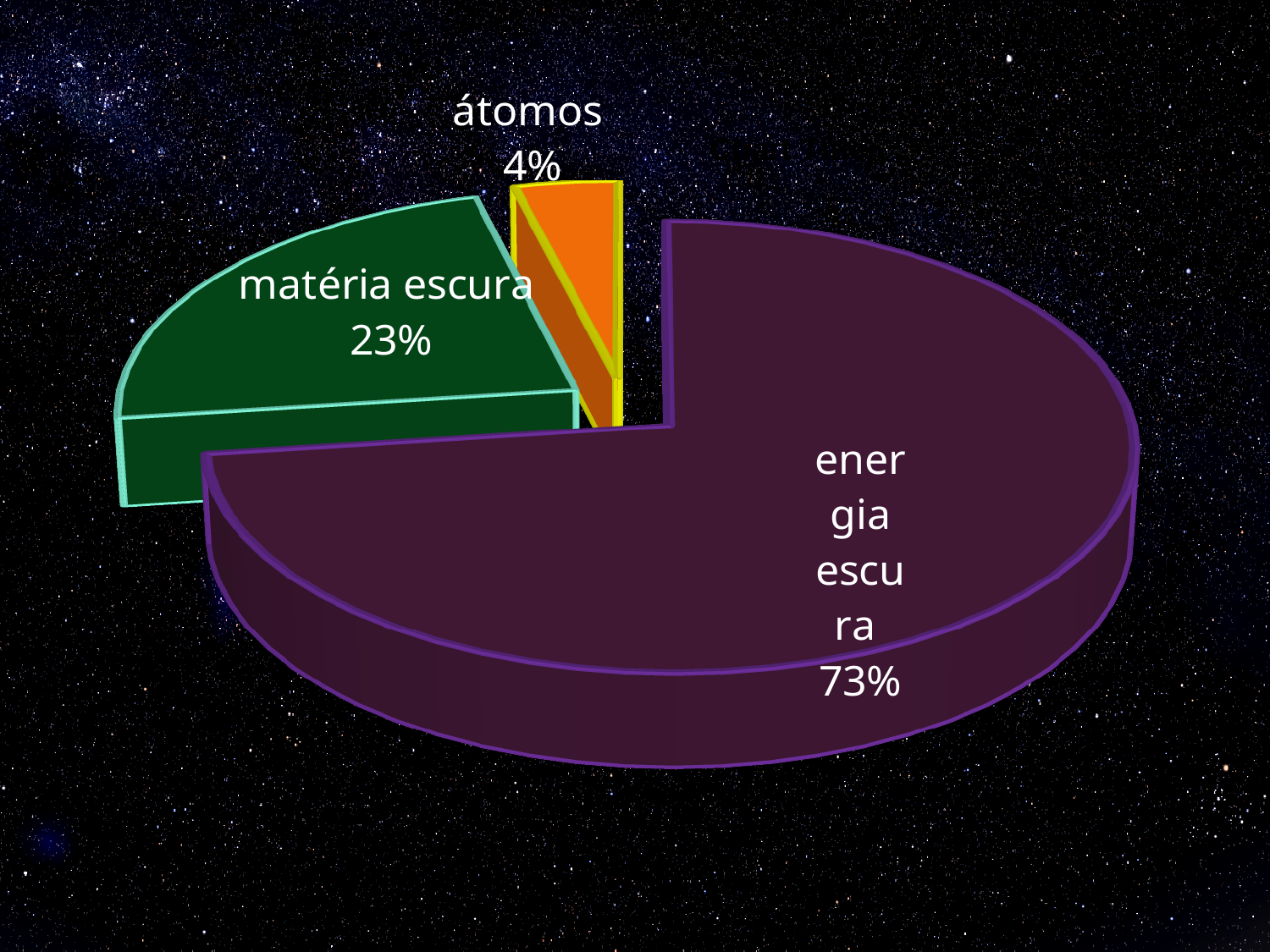
How many slices does the pie chart have? 3 What is the difference in percentage points between 'matéria escura' and 'átomos'? 19 What is the difference in percentage points between 'energia escura' and 'matéria escura'? 50 What percentage does the 'matéria escura' slice represent? 23% What colour is the 'átomos' slice? orange Which is larger, the 'matéria escura' slice or the 'átomos' slice? matéria escura What percentage does the 'átomos' slice represent? 4% Which slice of the pie is the largest? energia escura What kind of chart is shown on the slide? pie chart What colour is the 'matéria escura' slice? green What percentage does the 'energia escura' slice represent? 73% Which slice of the pie is the smallest? átomos